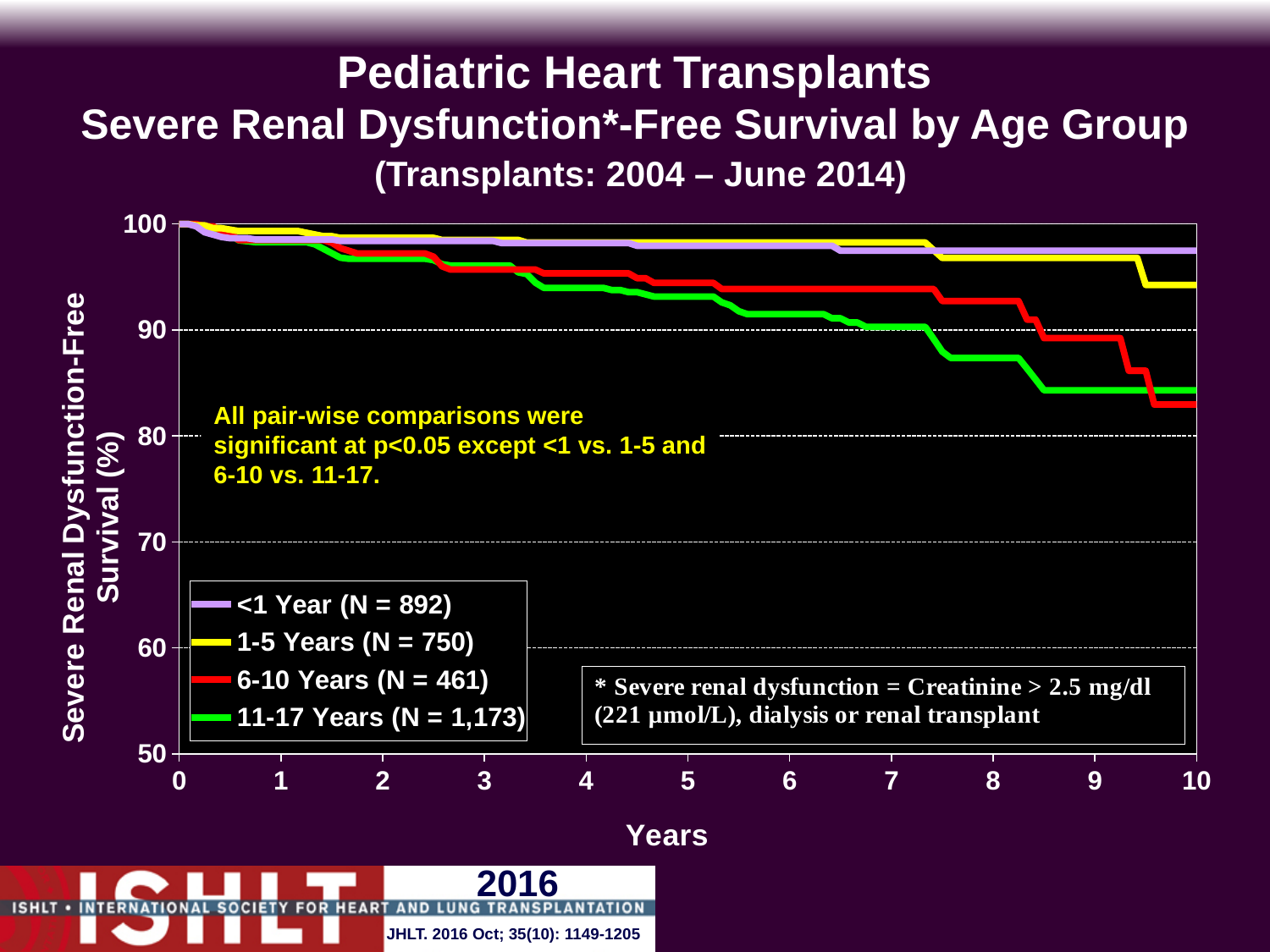
Is the value for the 1-5 Years group at 10 years greater or less than 90? greater What is the label of the x axis? Years Is the value for the 6-10 Years group at 10 years greater or less than 90? less What kind of chart is shown on the slide? Line chart What is the N for the 11-17 Years group shown in the legend? 1,173 Which age group has the highest severe renal dysfunction-free survival at 10 years? <1 Year At 10 years, which is larger: the survival for the <1 Year group or the 11-17 Years group? <1 Year Is the value for the 11-17 Years group at 10 years greater or less than 90? less What is the N for the 6-10 Years group shown in the legend? 461 How many series does the legend list? 4 Do the survival curves rise or fall as years since transplant increase? Fall